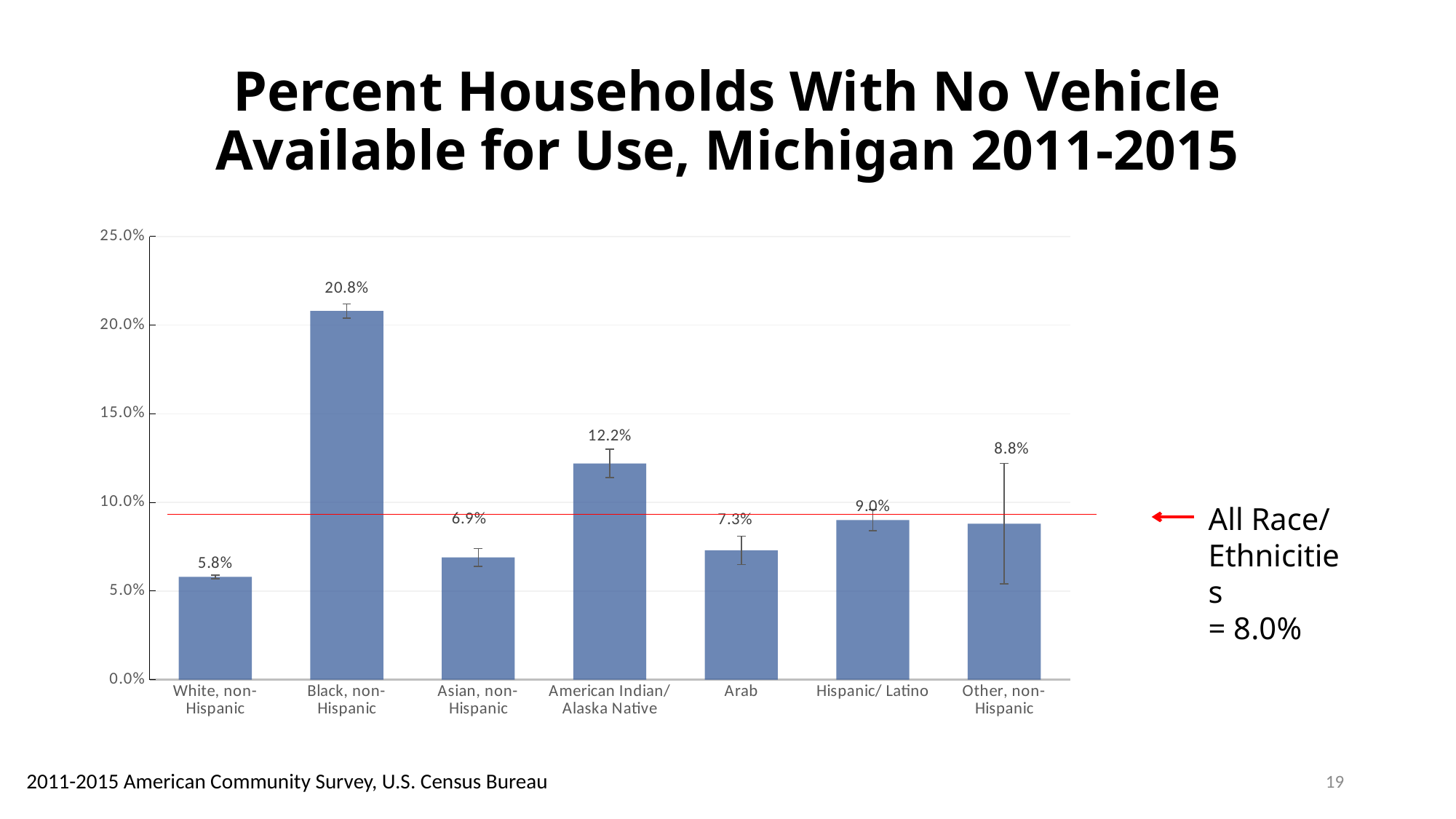
Is the value for Other, non-Hispanic households greater or less than 10.0%? less What kind of chart is shown on the slide? bar chart What is the value shown for White, non-Hispanic households? 5.8% How many race/ethnicity categories are shown on the chart? 7 What is the value shown for Hispanic/Latino households? 9.0% Which is larger, the value for Arab households or the value for Asian, non-Hispanic households? Arab What is the difference between the values for Black, non-Hispanic and White, non-Hispanic households? 15.0% What is the value shown for American Indian/Alaska Native households? 12.2% Which race/ethnicity category has the lowest percent of households with no vehicle available? White, non-Hispanic Which race/ethnicity category has the highest percent of households with no vehicle available? Black, non-Hispanic What value does the red horizontal line labelled 'All Race/Ethnicities' represent? 8.0% What is the percent of households with no vehicle available for Black, non-Hispanic households? 20.8%